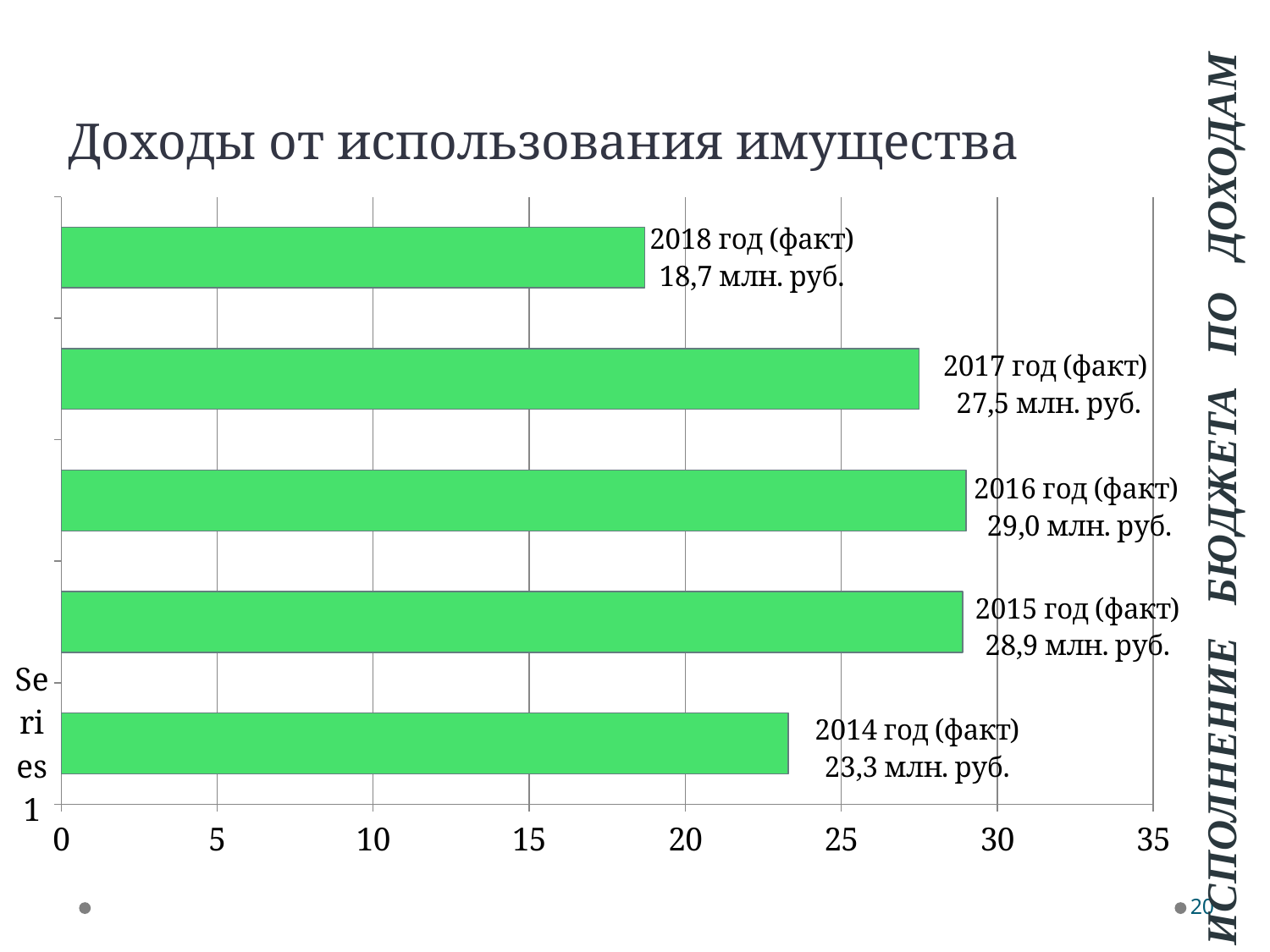
Is the value for 2018 год (факт) greater or less than 20? less Which year has the lowest value? 2018 год (факт) How many bars are shown in the chart? 5 What is the title of the chart? Доходы от использования имущества Is the value for 2016 год (факт) greater or less than 25? greater What is the value for 2014 год (факт)? 23,3 млн. руб. What is the value for 2015 год (факт)? 28,9 млн. руб. What is the value for 2018 год (факт)? 18,7 млн. руб. Which is larger, the value for 2014 год (факт) or 2017 год (факт)? 2017 год (факт) What is the difference between the values for 2017 год (факт) and 2018 год (факт)? 8,8 млн. руб. What kind of chart is shown on the slide? bar chart What is the difference between the values for 2016 год (факт) and 2014 год (факт)? 5,7 млн. руб.